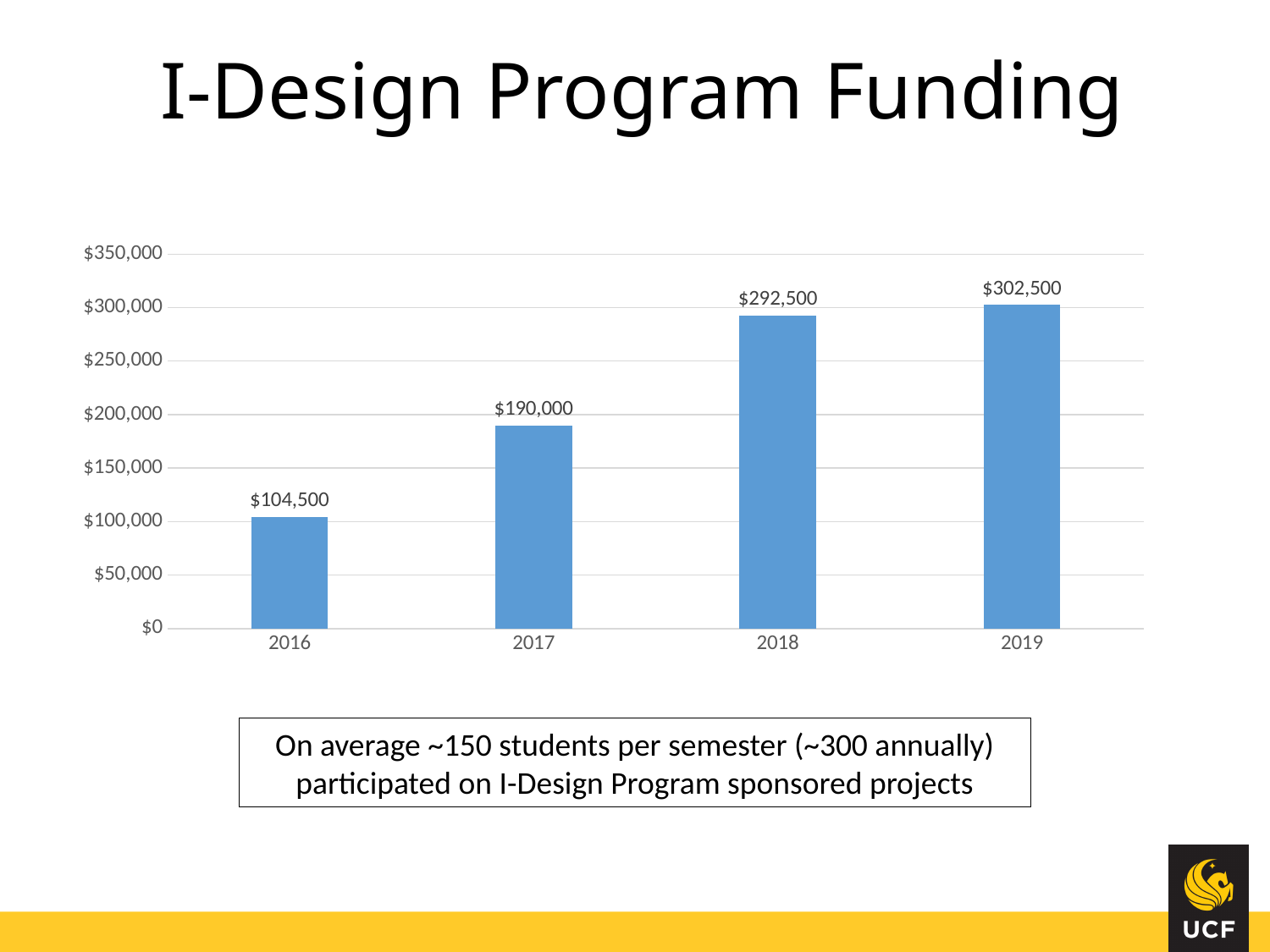
Which year had the highest I-Design Program funding? 2019 What was the I-Design Program funding in 2018? $292,500 Does the funding rise or fall from 2016 to 2019? Rise How many years are shown in the chart? 4 How much more funding was there in 2019 than in 2018? $10,000 What is the difference in funding between 2017 and 2016? $85,500 What was the I-Design Program funding in 2017? $190,000 Which year had the lowest I-Design Program funding? 2016 Which year had more funding, 2017 or 2018? 2018 What was the I-Design Program funding in 2019? $302,500 What type of chart is shown on the slide? Bar chart What was the I-Design Program funding in 2016? $104,500